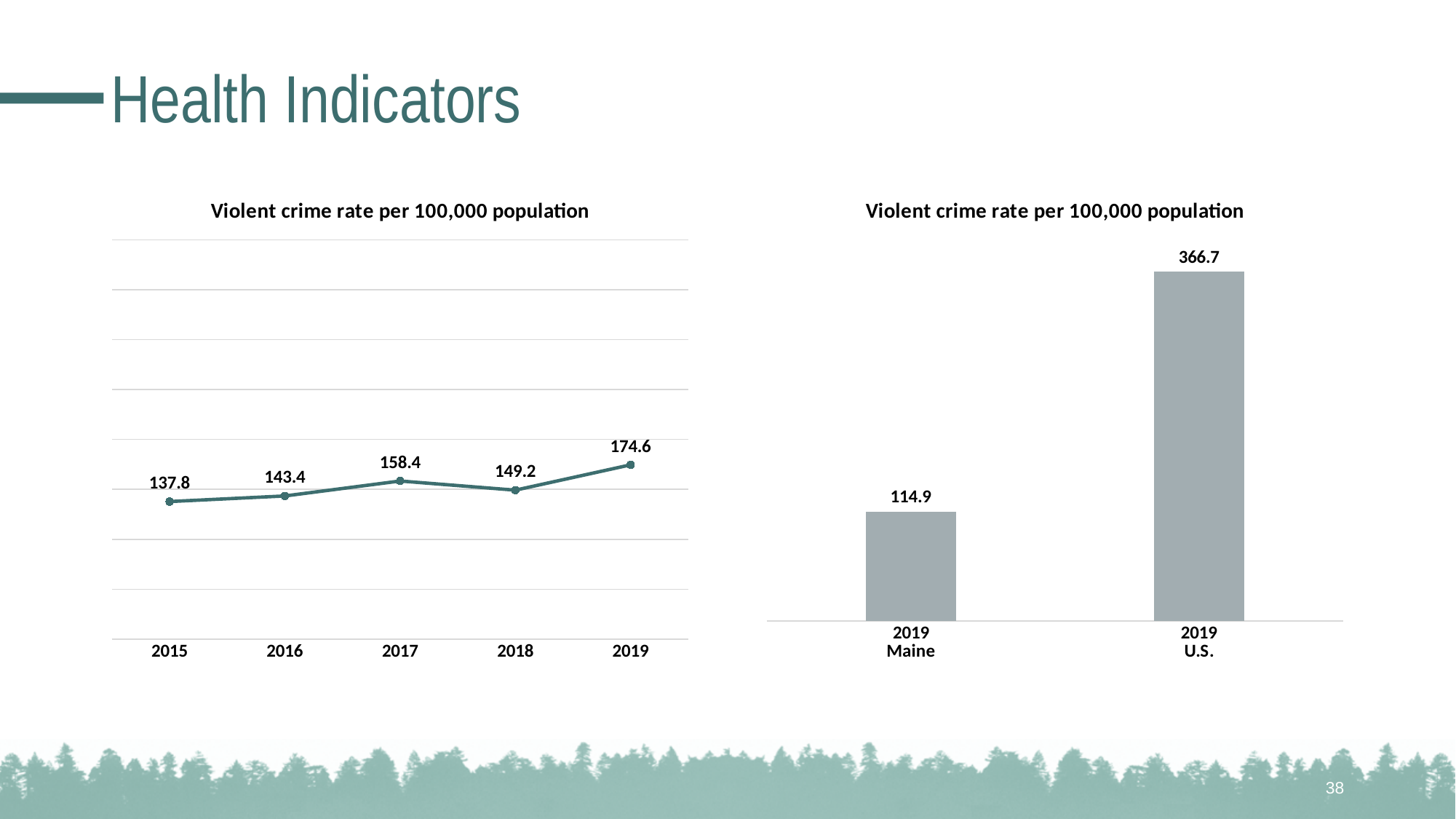
In the left chart, which is larger, the value for 2017 or the value for 2018? 2017 In the right chart, what is the violent crime rate per 100,000 population for Maine in 2019? 114.9 What kind of chart is the left chart? line chart In the left chart, which year has the lowest violent crime rate? 2015 In the left chart, what is the value for 2015? 137.8 In the left chart, what is the violent crime rate per 100,000 population in 2017? 158.4 What kind of chart is the right chart? bar chart In the left chart, what is the difference between the 2019 value and the 2015 value? 36.8 How many years are plotted in the left chart? 5 In the left chart, which year has the highest violent crime rate? 2019 In the right chart, what is the value for the U.S. in 2019? 366.7 In the right chart, what is the difference between the U.S. value and the Maine value? 251.8